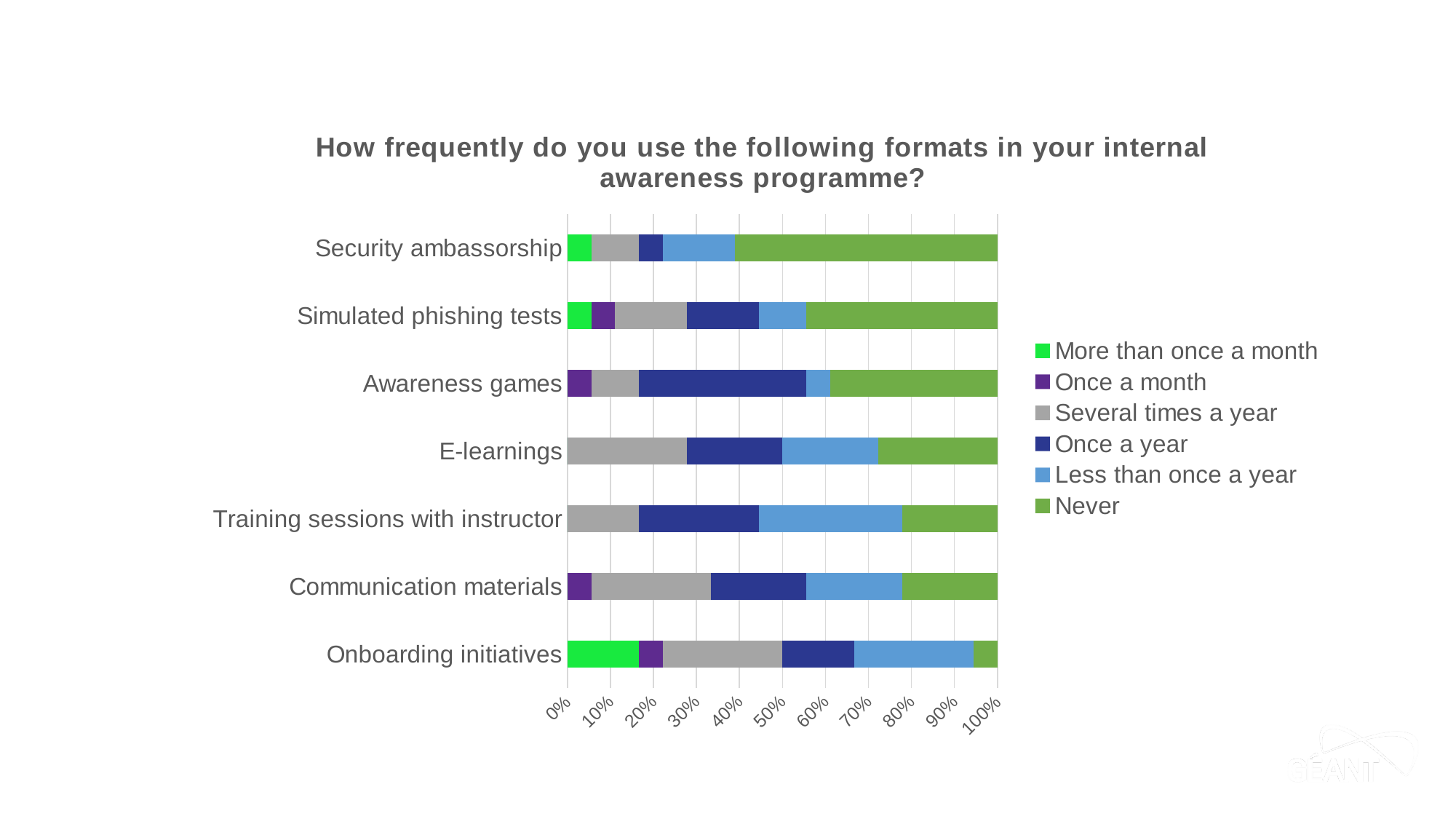
Which has a larger 'Once a year' share: Awareness games or Security ambassorship? Awareness games Which format has the largest 'More than once a month' share? Onboarding initiatives Is the 'Never' share for Onboarding initiatives greater or less than 10%? less Is the 'Never' share for Security ambassorship greater or less than 50%? greater Which legend entry is shown in green at the bottom of the legend? Never Which format has the largest 'Never' share? Security ambassorship Which format has the smallest 'Never' share? Onboarding initiatives What kind of chart is shown on the slide? Stacked bar chart How many series does the chart's legend list? 6 Which has a larger 'Never' share: Simulated phishing tests or E-learnings? Simulated phishing tests What is the title of the chart? How frequently do you use the following formats in your internal awareness programme? How many formats (categories) are listed on the vertical axis of the chart? 7